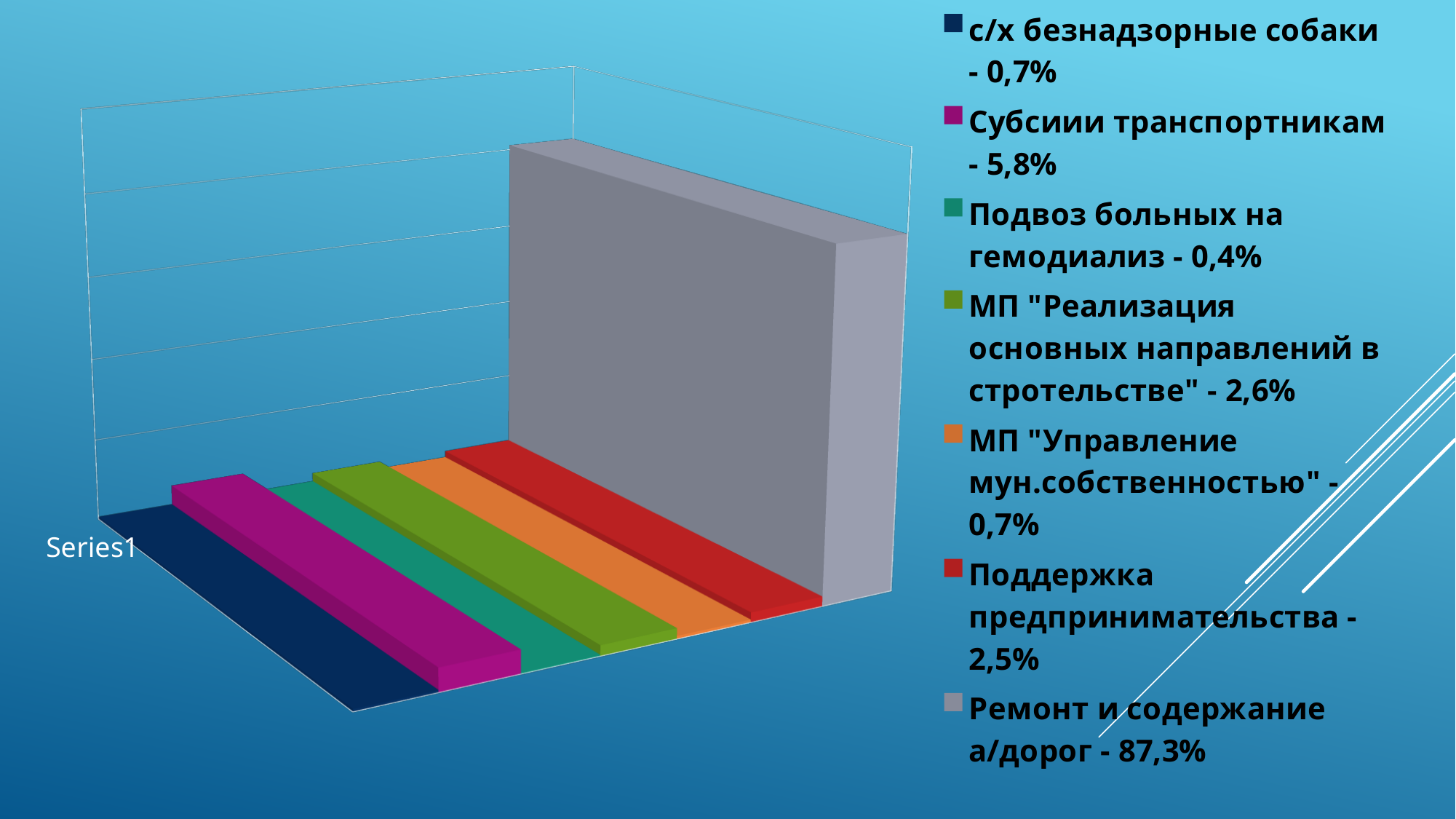
What percentage is shown for "Ремонт и содержание а/дорог"? 87,3% Which legend entry has the lowest percentage? Подвоз больных на гемодиализ What percentage is shown for "Подвоз больных на гемодиализ"? 0,4% Which is larger: the percentage for "МП "Реализация основных направлений в стротельстве"" or for "Поддержка предпринимательства"? МП "Реализация основных направлений в стротельстве" What label is shown on the category axis of the chart? Series1 What colour is the bar for "Ремонт и содержание а/дорог"? grey What percentage is shown for "Поддержка предпринимательства"? 2,5% What kind of chart is shown on the slide? bar chart What percentage is shown for "Субсиии транспортникам"? 5,8% How many entries does the legend list? 7 What is the difference between the percentages for "Ремонт и содержание а/дорог" and "Субсиии транспортникам"? 81,5% Which legend entry has the highest percentage? Ремонт и содержание а/дорог